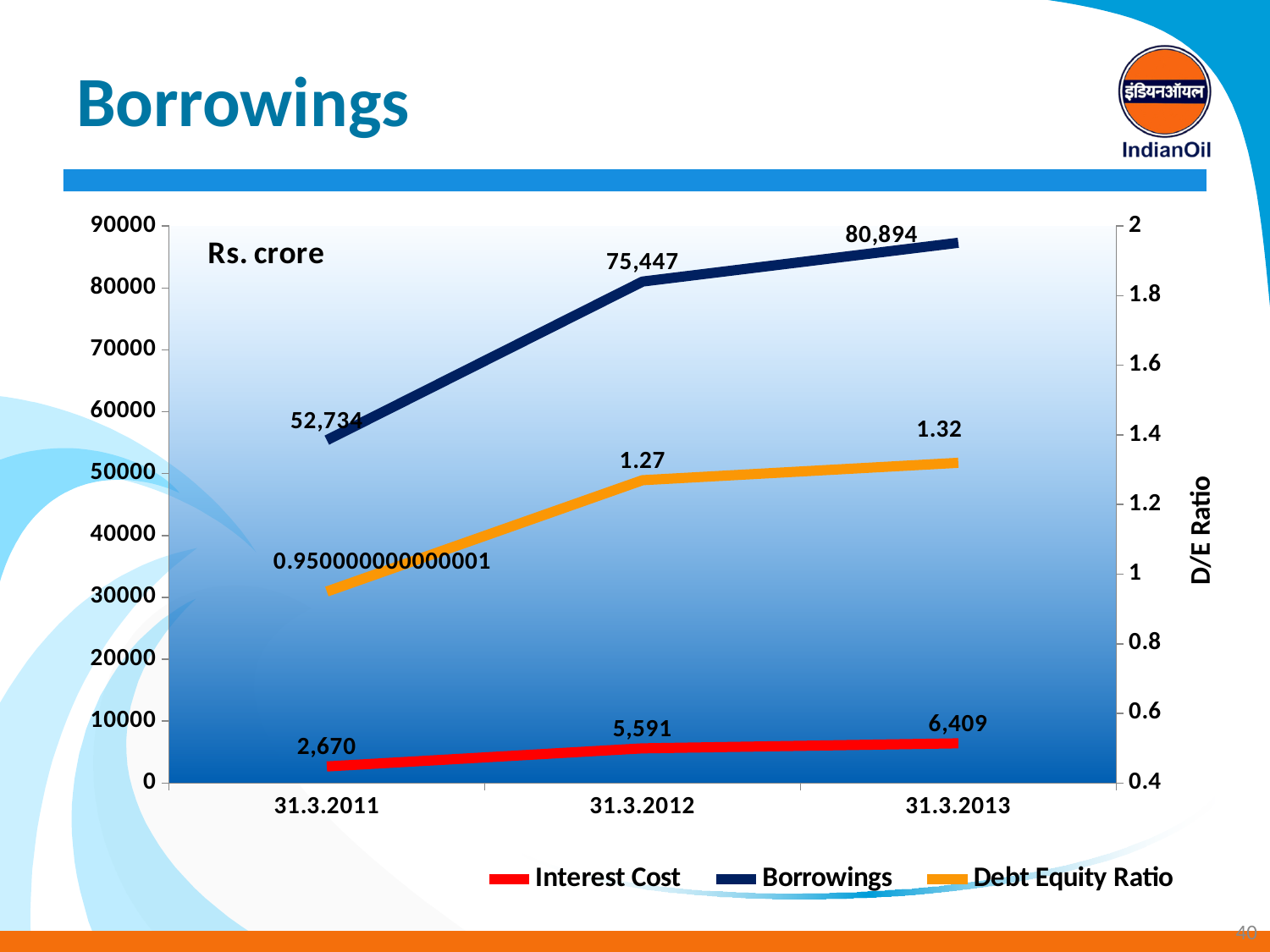
What type of chart is shown on the slide? line chart How many series does the legend list? 3 At which date is Borrowings highest? 31.3.2013 What is the value of Borrowings at 31.3.2012? 75,447 At which date is the Interest Cost lowest? 31.3.2011 What is the Debt Equity Ratio at 31.3.2012? 1.27 How many dates are plotted on the x axis? 3 What is the Interest Cost at 31.3.2013? 6,409 What is the difference between Borrowings at 31.3.2013 and at 31.3.2011? 28,160 What is the label of the secondary (right-hand) y axis? D/E Ratio Which is larger: Interest Cost at 31.3.2012 or Interest Cost at 31.3.2013? 31.3.2013 Do Borrowings rise or fall from 31.3.2011 to 31.3.2013? rise